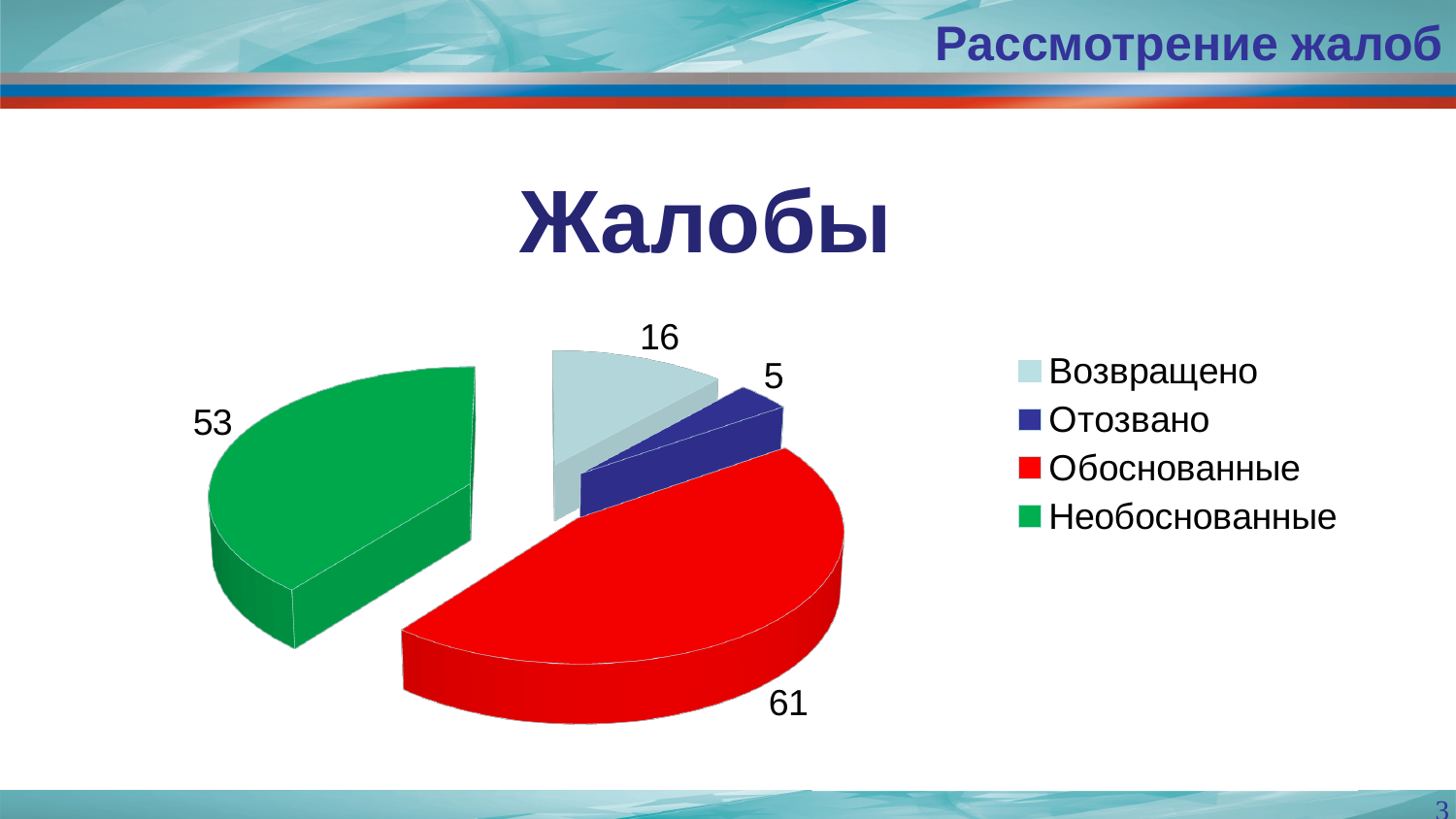
What is the value for Отозвано? 5 Which category has the largest slice? Обоснованные What is the title of the chart? Жалобы Which is larger, Возвращено or Отозвано? Возвращено Which category has the smallest slice? Отозвано What is the difference between the values for Обоснованные and Необоснованные? 8 How many slices does the pie chart have? 4 What is the value for Возвращено? 16 What type of chart is shown on the slide? pie chart What is the value for Необоснованные? 53 What is the value for Обоснованные? 61 What is the total of all four slices? 135